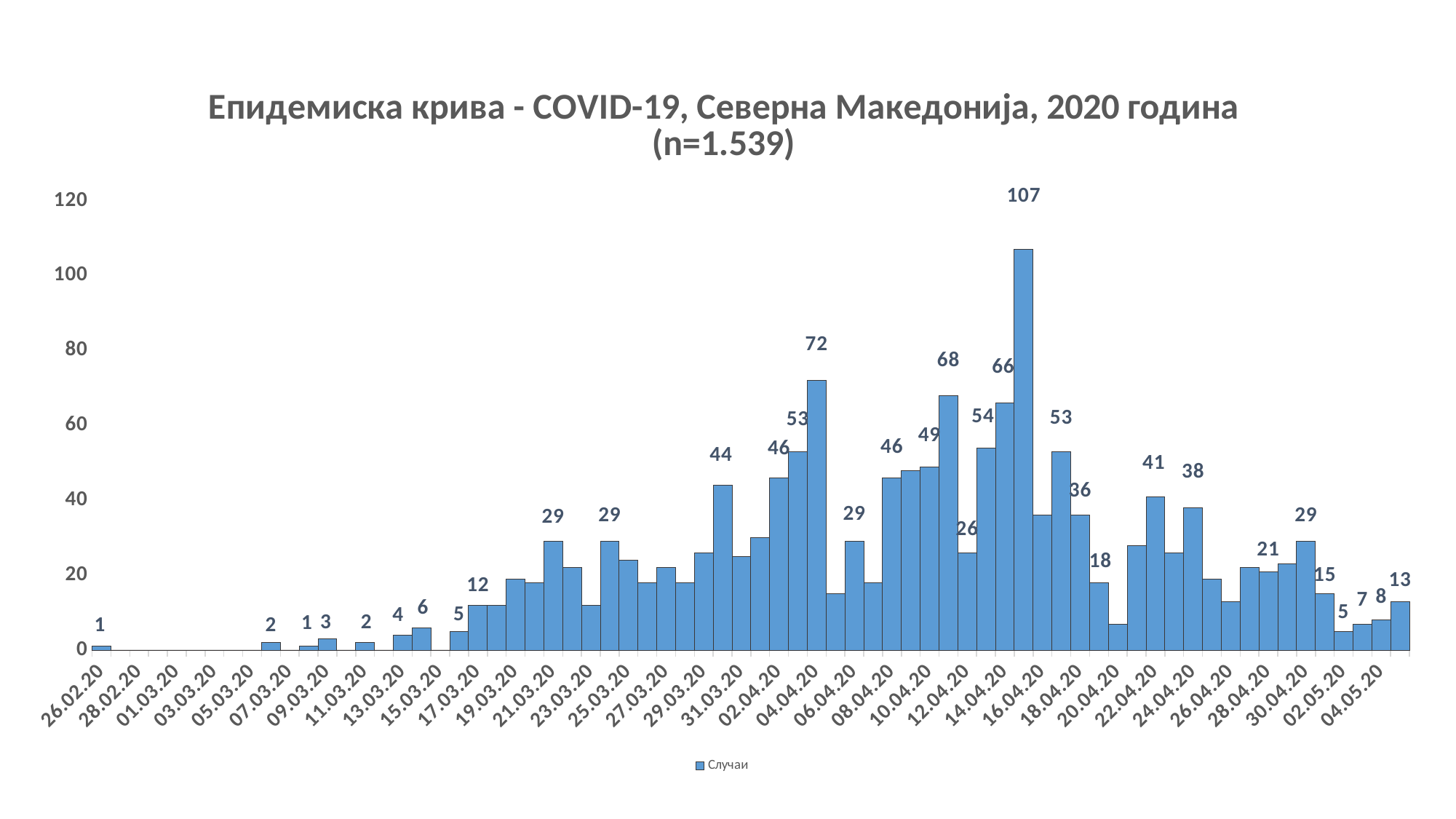
What is the value for 26.02.20? 1 What is the highest daily value shown on the chart? 107 What total number of cases (n) is given in the chart title? 1.539 What is the value for 02.05.20? 5 What is the value for 14.04.20? 66 How many series does the legend list? 1 What kind of chart is shown on the slide? bar chart Which has the larger value, 22.04.20 or 24.04.20? 22.04.20 What is the value for 22.04.20? 41 What is the value for 04.04.20? 72 What is the difference between the values for 04.04.20 and 14.04.20? 6 Is the value for 08.04.20 greater or less than 40? greater